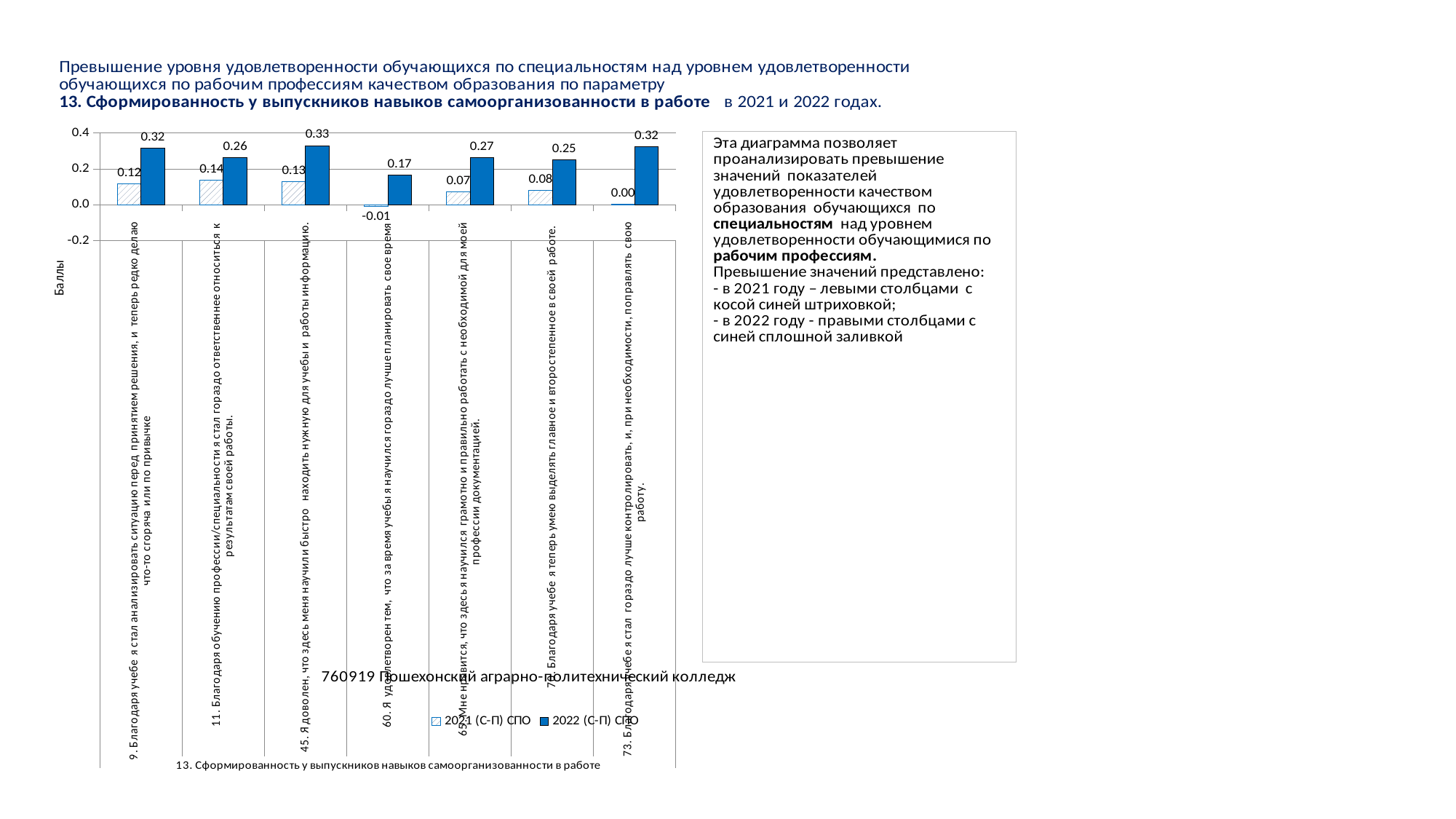
What is the difference between the 2022 and 2021 values for statement 9 ("Благодаря учебе я стал анализировать ситуацию перед принятием решения...")? 0.20 How many categories (statements) are plotted on the x axis? 7 Which statement has the highest 2021 (С-П) СПО value? 11. Благодаря обучению профессии/специальности я стал гораздо ответственнее относиться к результатам своей работы. What is the 2021 (С-П) СПО value for statement 60 ("Я удовлетворен тем, что за время учебы я научился гораздо лучше планировать свое время")? -0.01 According to the legend, which series is shown with solid blue fill? 2022 (С-П) СПО What type of chart is shown on the slide? bar chart For statement 65 ("Мне нравится, что здесь я научился грамотно и правильно работать с необходимой для моей профессии документацией"), which series has the larger value, 2021 (С-П) СПО or 2022 (С-П) СПО? 2022 (С-П) СПО Which statement has the lowest 2022 (С-П) СПО value? 60. Я удовлетворен тем, что за время учебы я научился гораздо лучше планировать свое время What is the 2021 (С-П) СПО value for statement 73 ("Благодаря учебе я стал гораздо лучше контролировать... свою работу")? 0.00 How many series does the legend list? 2 Which statement has the highest 2022 (С-П) СПО value? 45. Я доволен, что здесь меня научили быстро находить нужную для учебы и работы информацию. What is the 2022 (С-П) СПО value for statement 45 ("Я доволен, что здесь меня научили быстро находить нужную для учебы и работы информацию")? 0.33